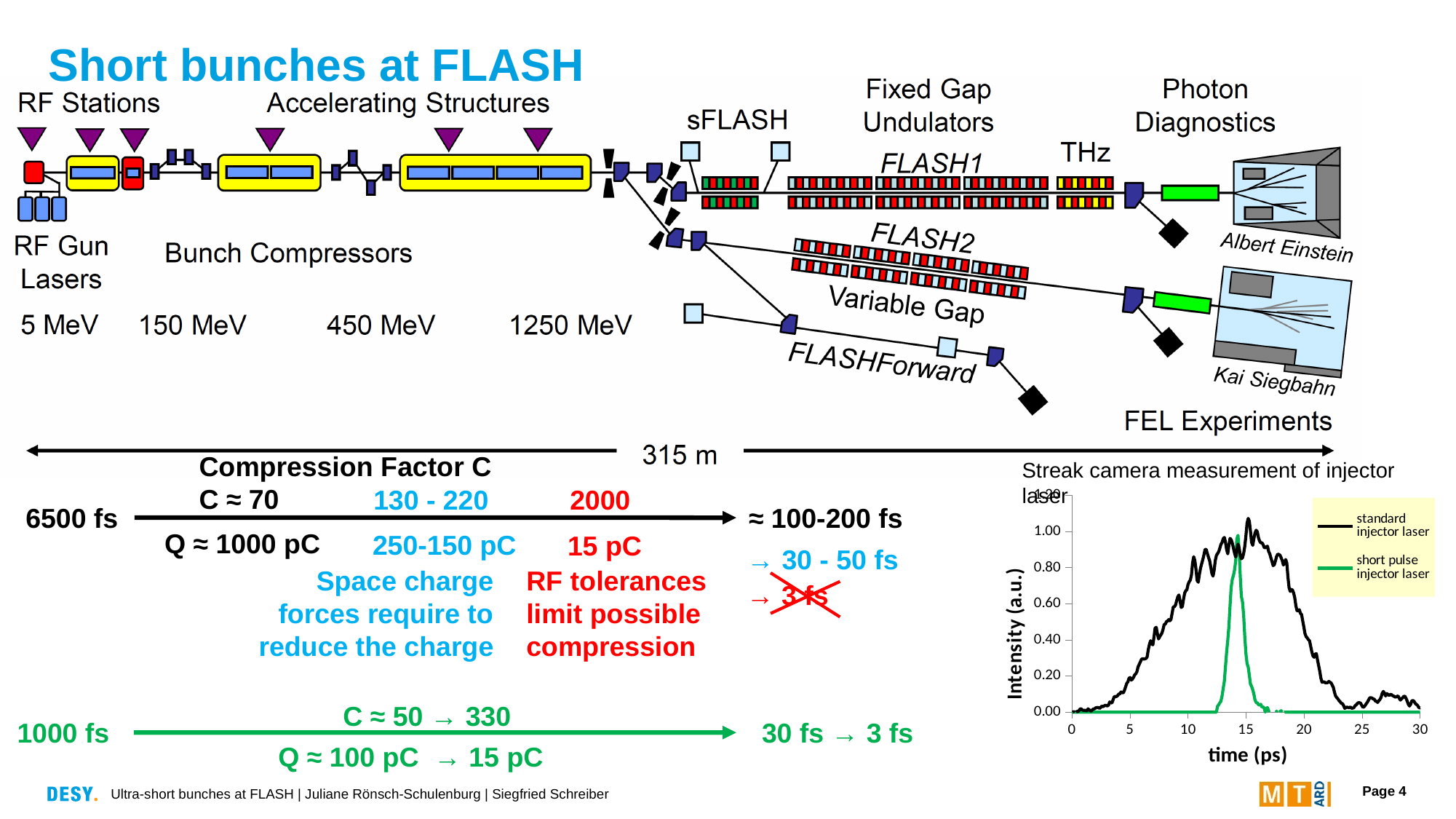
How many series does the legend of the streak camera measurement chart list? 2 In the streak camera measurement chart, is the intensity of the short pulse injector laser at 10 ps greater or less than 0.20? less What are the two series named in the legend of the streak camera measurement chart? standard injector laser, short pulse injector laser In the streak camera measurement chart, does the intensity of the standard injector laser rise or fall between 5 ps and 10 ps? rise In the streak camera measurement chart, does the intensity of the standard injector laser rise or fall between 15 ps and 20 ps? fall In the streak camera measurement chart, is the intensity of the standard injector laser at 25 ps greater or less than 0.20? less What is the label of the x axis of the streak camera measurement chart? time (ps) In the streak camera measurement chart, is the peak value of the short pulse injector laser greater or less than 0.80? greater In the streak camera measurement chart, which series reaches the higher peak intensity, the standard injector laser or the short pulse injector laser? standard injector laser What kind of chart is the streak camera measurement chart? line chart